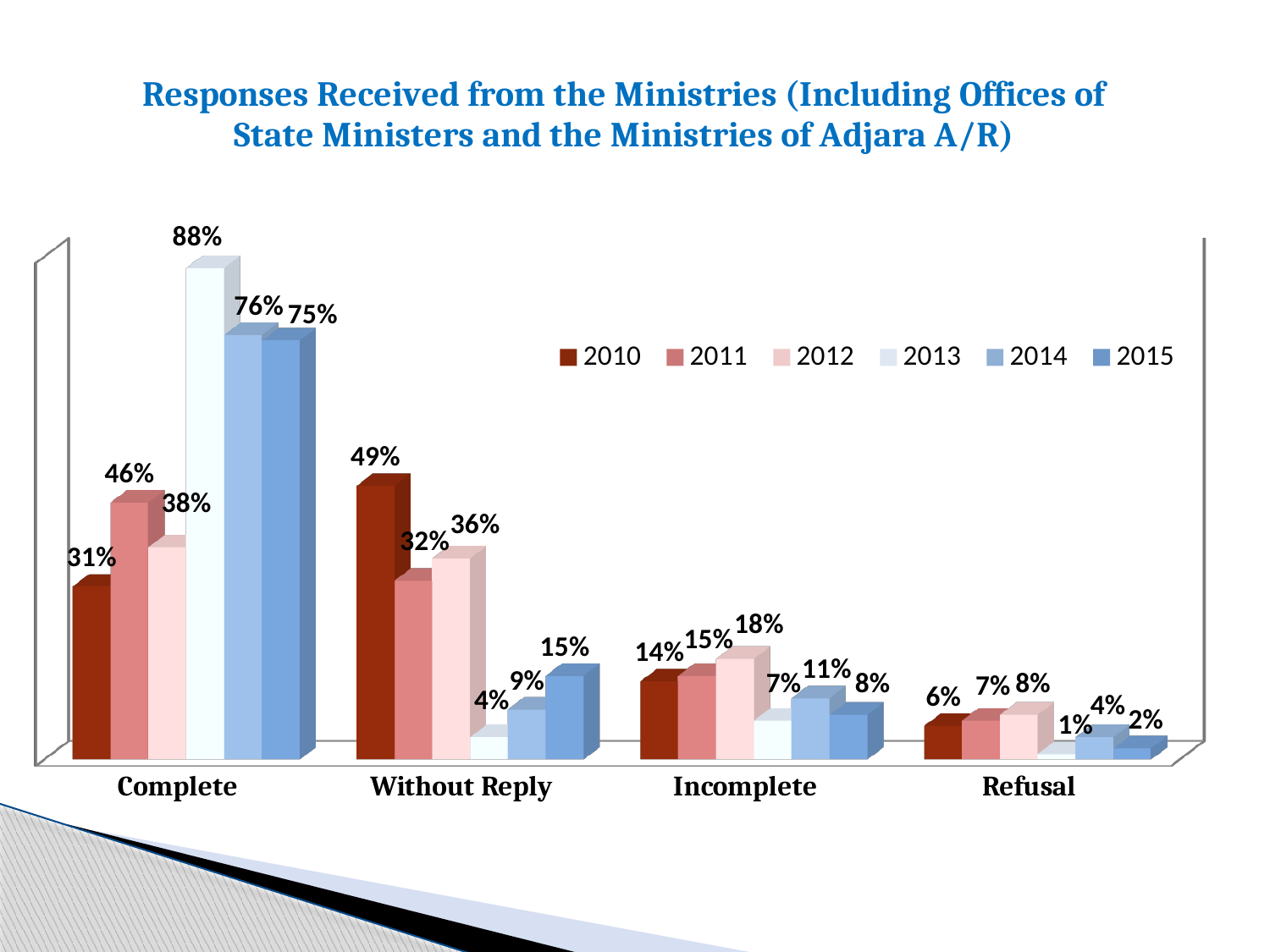
What kind of chart is shown on the slide? bar chart Do the values for 2010 fall or rise from Without Reply to Refusal along the x axis? fall Which year has the highest value in the Complete category? 2013 How many series does the legend list? 6 How many categories are shown on the x axis? 4 What is the value for 2015 in the Refusal category? 2% What is the value for 2010 in the Without Reply category? 49% Which is larger in the Incomplete category, the value for 2012 or the value for 2014? 2012 What is the difference between the 2013 and 2010 values in the Complete category? 57% What is the title of the chart? Responses Received from the Ministries (Including Offices of State Ministers and the Ministries of Adjara A/R) What is the value for 2013 in the Complete category? 88% Which year has the lowest value in the Without Reply category? 2013